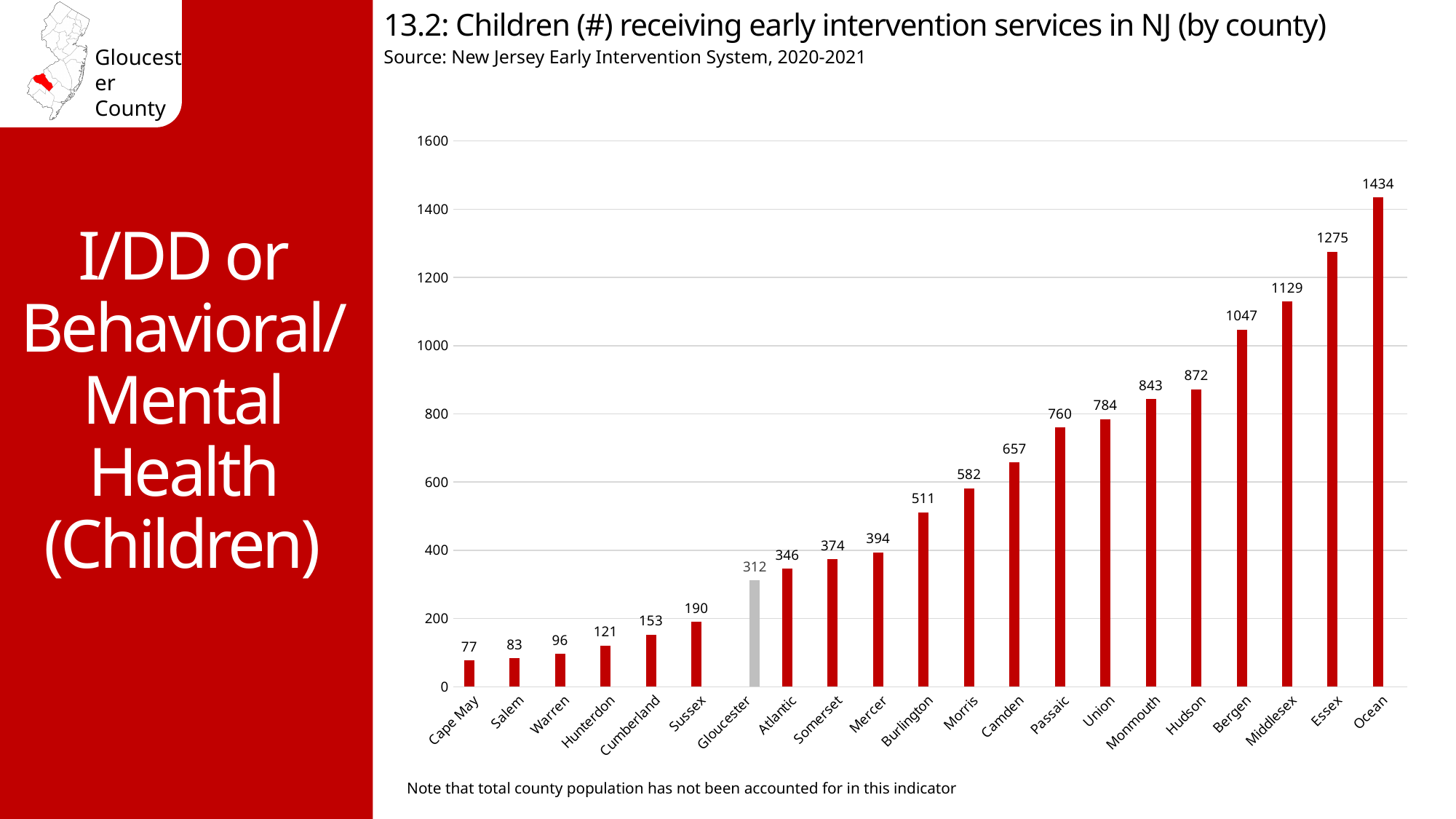
What kind of chart is shown on the slide? bar chart What is the difference between the values for Essex and Ocean? 159 Which county's bar is shown in gray instead of red? Gloucester Which county has the highest number of children receiving early intervention services? Ocean Which county has the lowest number of children receiving early intervention services? Cape May Is the value for Passaic greater or less than 800? less How many counties are shown on the chart? 21 Which has a larger value, Bergen or Hudson? Bergen How many children received early intervention services in Gloucester County? 312 What is the difference between the values for Gloucester and Atlantic? 34 What is the value shown for Camden? 657 Do the values rise or fall moving from left to right along the x axis? rise